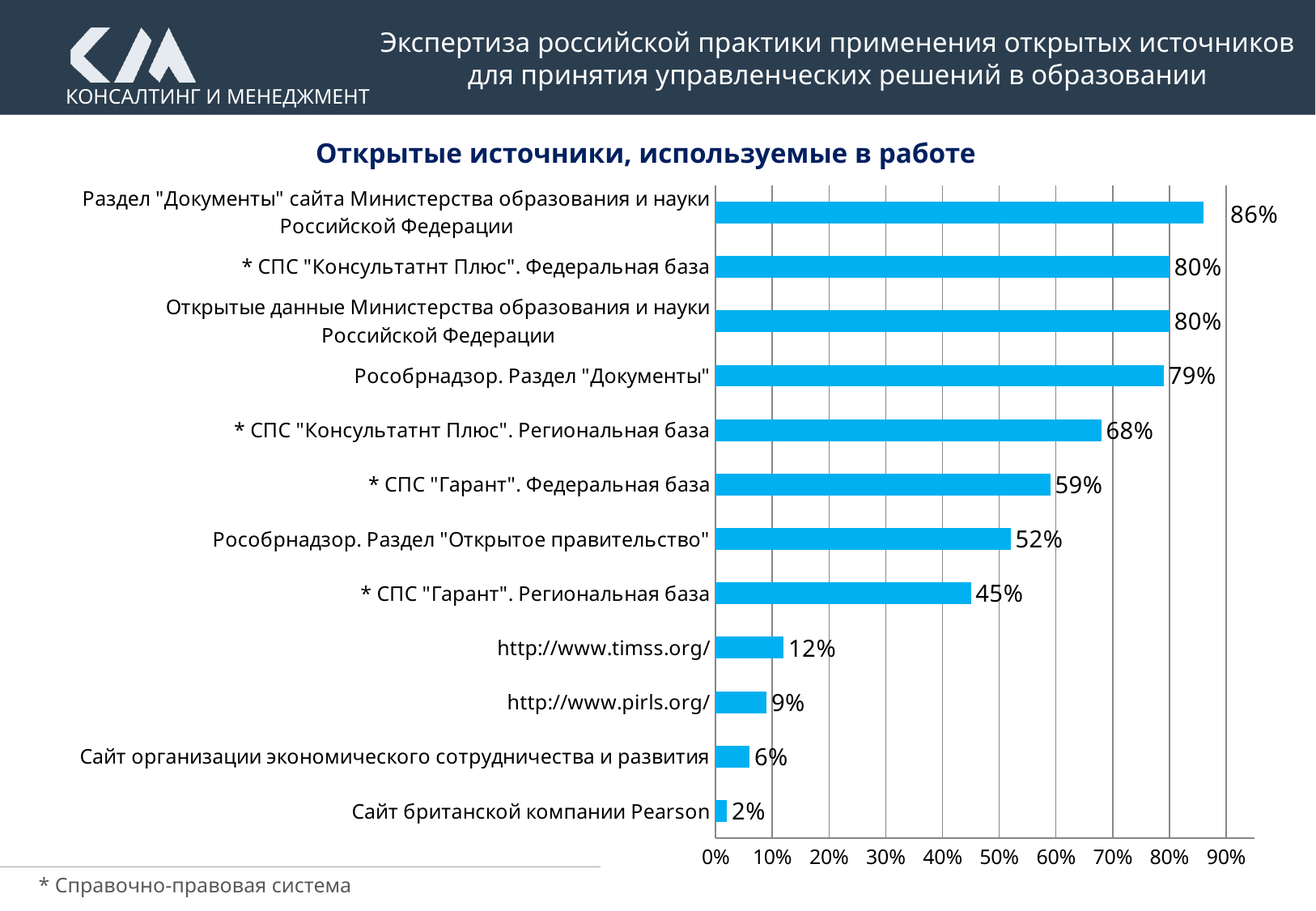
What is the value for http://www.timss.org/? 12% Which category has the lowest value? Сайт британской компании Pearson What is the title of the chart? Открытые источники, используемые в работе Which is larger: the value for Рособрнадзор. Раздел "Открытое правительство" or the value for * СПС "Гарант". Федеральная база? * СПС "Гарант". Федеральная база Which category has the highest value? Раздел "Документы" сайта Министерства образования и науки Российской Федерации What is the value for Раздел "Документы" сайта Министерства образования и науки Российской Федерации? 86% Is the value for Рособрнадзор. Раздел "Документы" greater or less than 70%? greater What is the value for * СПС "Гарант". Региональная база? 45% What is the difference between the values for * СПС "Консультатнт Плюс". Федеральная база and * СПС "Консультатнт Плюс". Региональная база? 12% What is the difference between the values for http://www.pirls.org/ and Сайт организации экономического сотрудничества и развития? 3% How many categories are shown in the chart? 12 What kind of chart is shown on the slide? bar chart